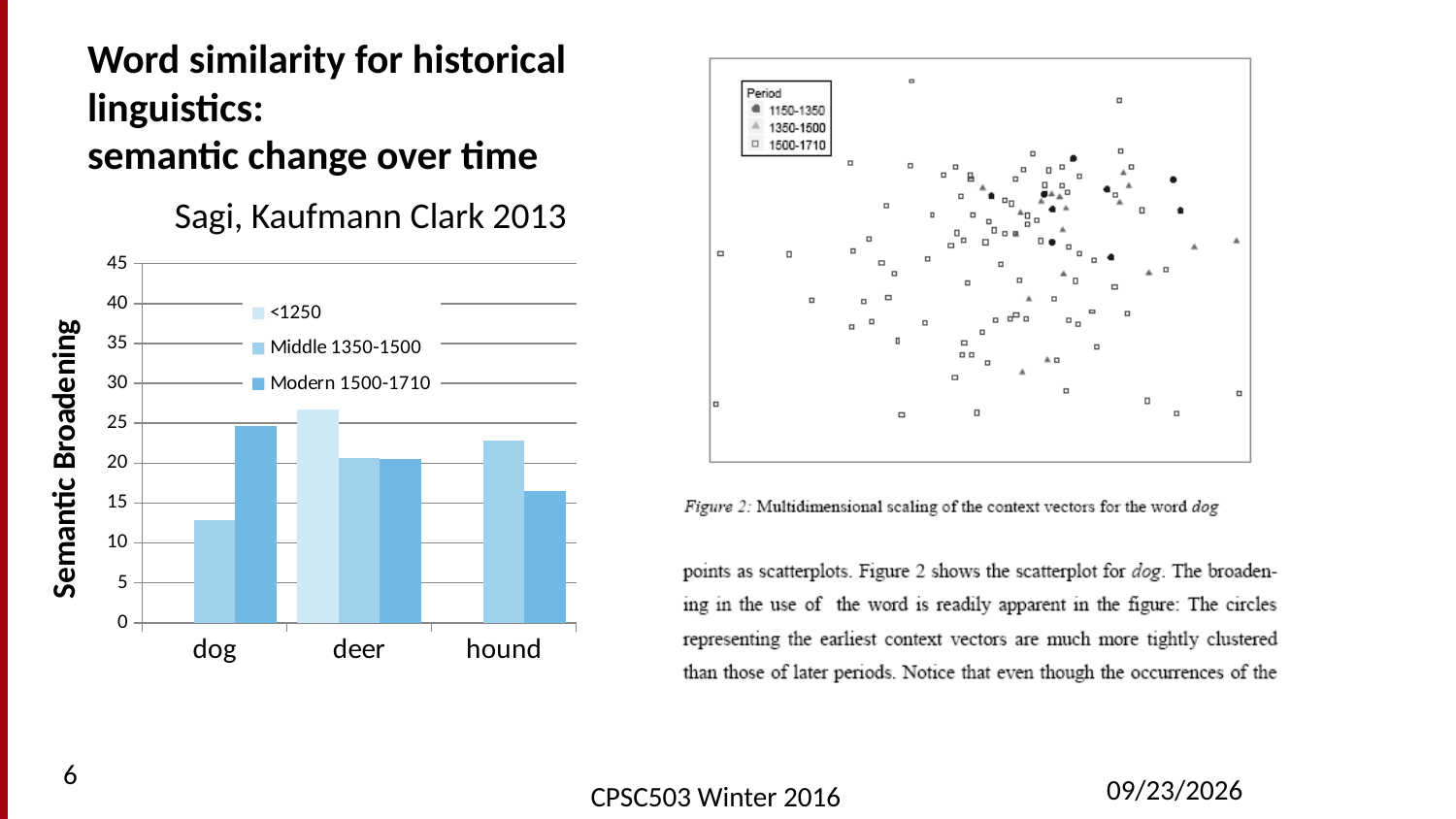
What is the y-axis title of the left-hand bar chart? Semantic Broadening In the left-hand bar chart, which is larger for dog: the Middle 1350-1500 value or the Modern 1500-1710 value? Modern 1500-1710 In the left-hand bar chart, is the Middle 1350-1500 value for hound greater or less than 20? greater In the left-hand bar chart, which is larger for hound: the Middle 1350-1500 value or the Modern 1500-1710 value? Middle 1350-1500 In the left-hand bar chart, is the Middle 1350-1500 value for dog greater or less than 15? less In the left-hand bar chart, which category has the lowest bar overall? dog What kind of chart is the left-hand chart on the slide (the one with dog, deer and hound)? bar chart How many periods does the legend of the right-hand scatterplot (Figure 2) list? 3 How many categories are shown on the x axis of the left-hand bar chart? 3 In the left-hand bar chart, is the Modern 1500-1710 value for hound greater or less than 20? less How many series does the legend of the left-hand bar chart list? 3